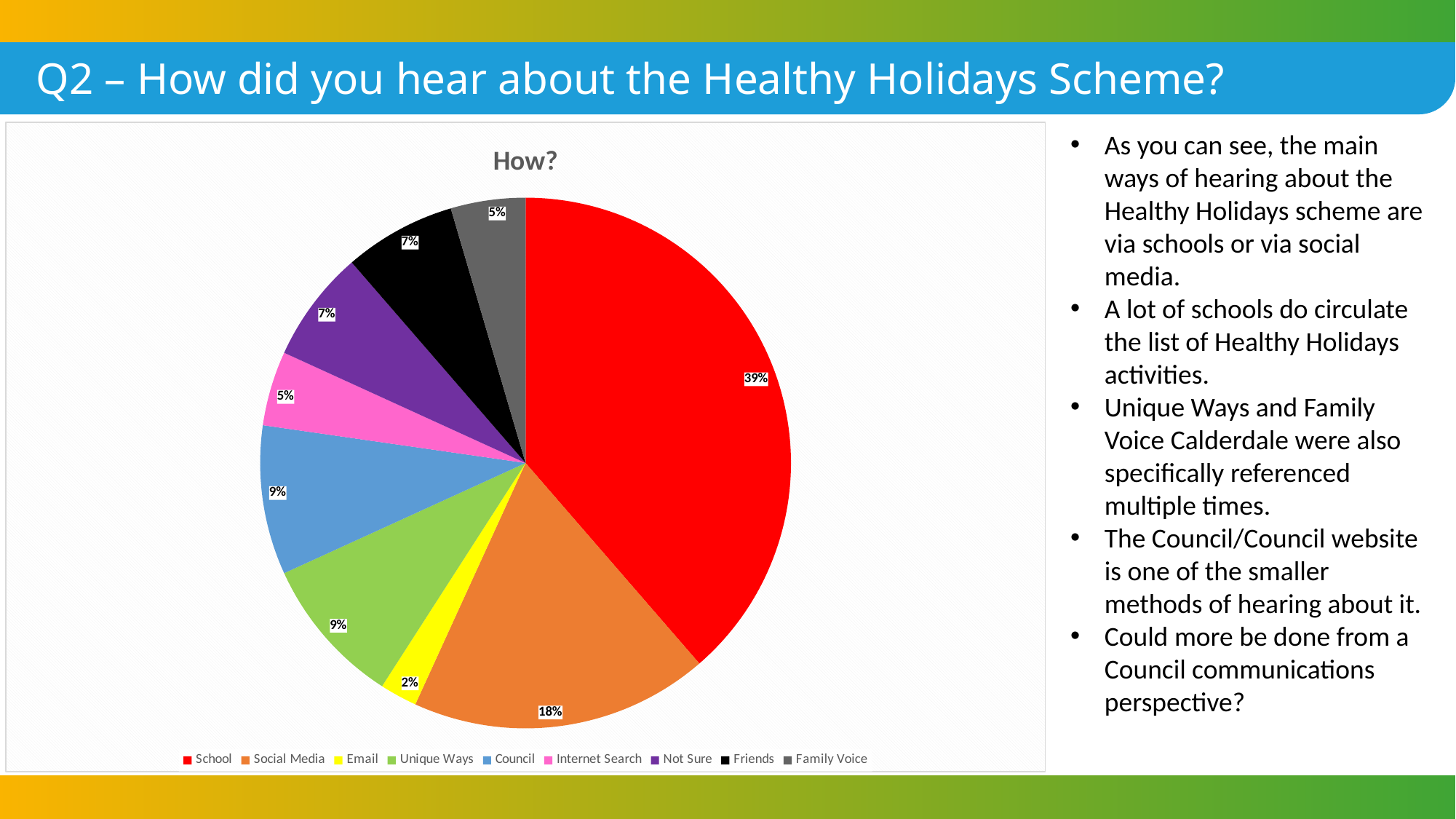
What kind of chart is shown on the slide? Pie chart Which is larger, the share for Not Sure or the share for Internet Search? Not Sure What share of the pie does Email account for? 2% How many categories does the legend list? 9 What is the difference in percentage points between School and Social Media? 21 What percentage is shown for Council? 9% What colour is the slice for Friends? Black Which category has the largest slice of the pie? School What percentage of respondents heard about the scheme through Social Media? 18% What percentage of respondents heard about the scheme through School? 39% Which category has the smallest slice of the pie? Email What is the chart's title? How?